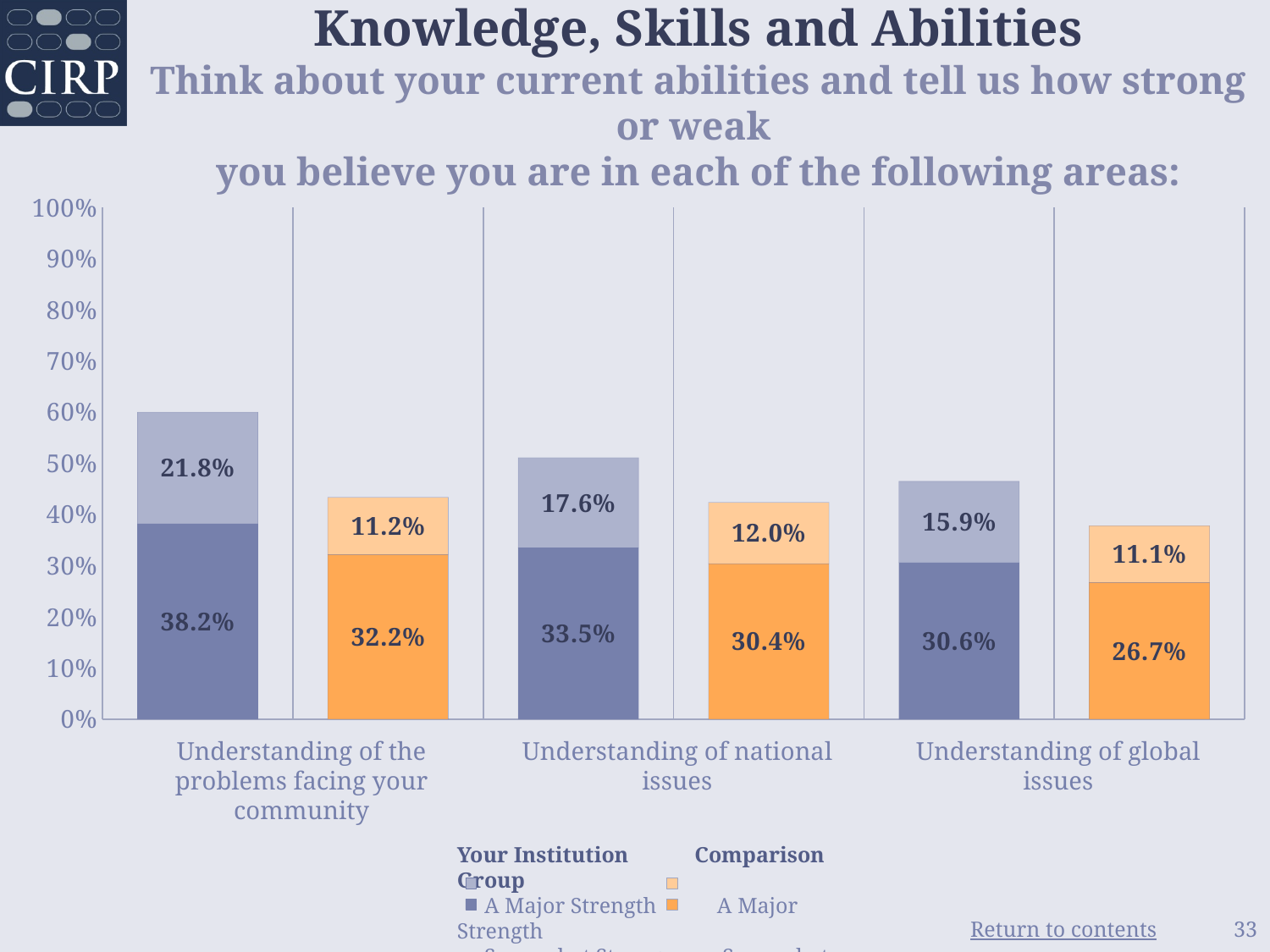
What is the value of the upper (lighter) segment of the Your Institution bar for 'Understanding of national issues'? 17.6% What is the total height of the Your Institution stacked bar for 'Understanding of the problems facing your community'? 60.0% What percentage of Your Institution students rated 'Understanding of the problems facing your community' as A Major Strength? 38.2% Which category has the highest A Major Strength value for Your Institution? Understanding of the problems facing your community How many categories are shown on the x axis of the chart? 3 For 'Understanding of the problems facing your community', how much higher is the Your Institution A Major Strength value than the Comparison Group's? 6.0 percentage points Which category has the lowest A Major Strength value for the Comparison Group? Understanding of global issues What is the Comparison Group's A Major Strength value for 'Understanding of global issues'? 26.7% For 'Understanding of national issues', which is larger: the upper segment of the Your Institution bar (17.6%) or the upper segment of the Comparison Group bar (12.0%)? Your Institution What type of chart is shown on the slide? Stacked bar chart Is the total of the Comparison Group bar for 'Understanding of the problems facing your community' greater or less than 50%? less What is the total of the Comparison Group stacked bar for 'Understanding of national issues'? 42.4%